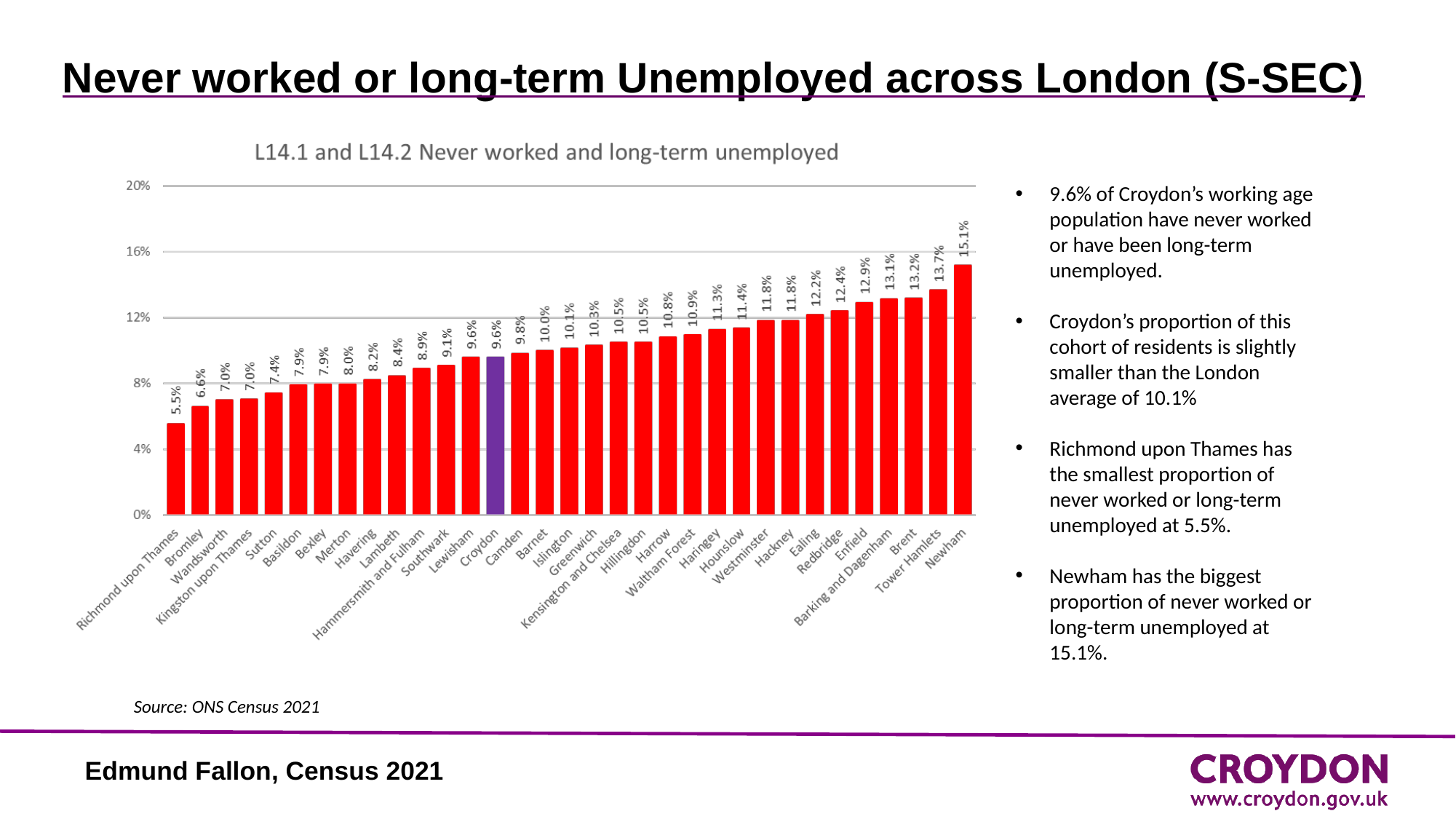
What is the difference between the values for Newham and Richmond upon Thames? 9.6% How many boroughs are shown on the chart? 33 What is the value for Tower Hamlets? 13.7% What is the value for Hammersmith and Fulham? 8.9% Which borough has the highest value? Newham Which borough has the lowest value? Richmond upon Thames Which has a larger value, Ealing or Harrow? Ealing What is the value for Croydon? 9.6% What kind of chart is this? Bar chart Which bar is coloured purple instead of red? Croydon What is the value for Newham? 15.1% What is the difference between the values for Brent and Croydon? 3.6%